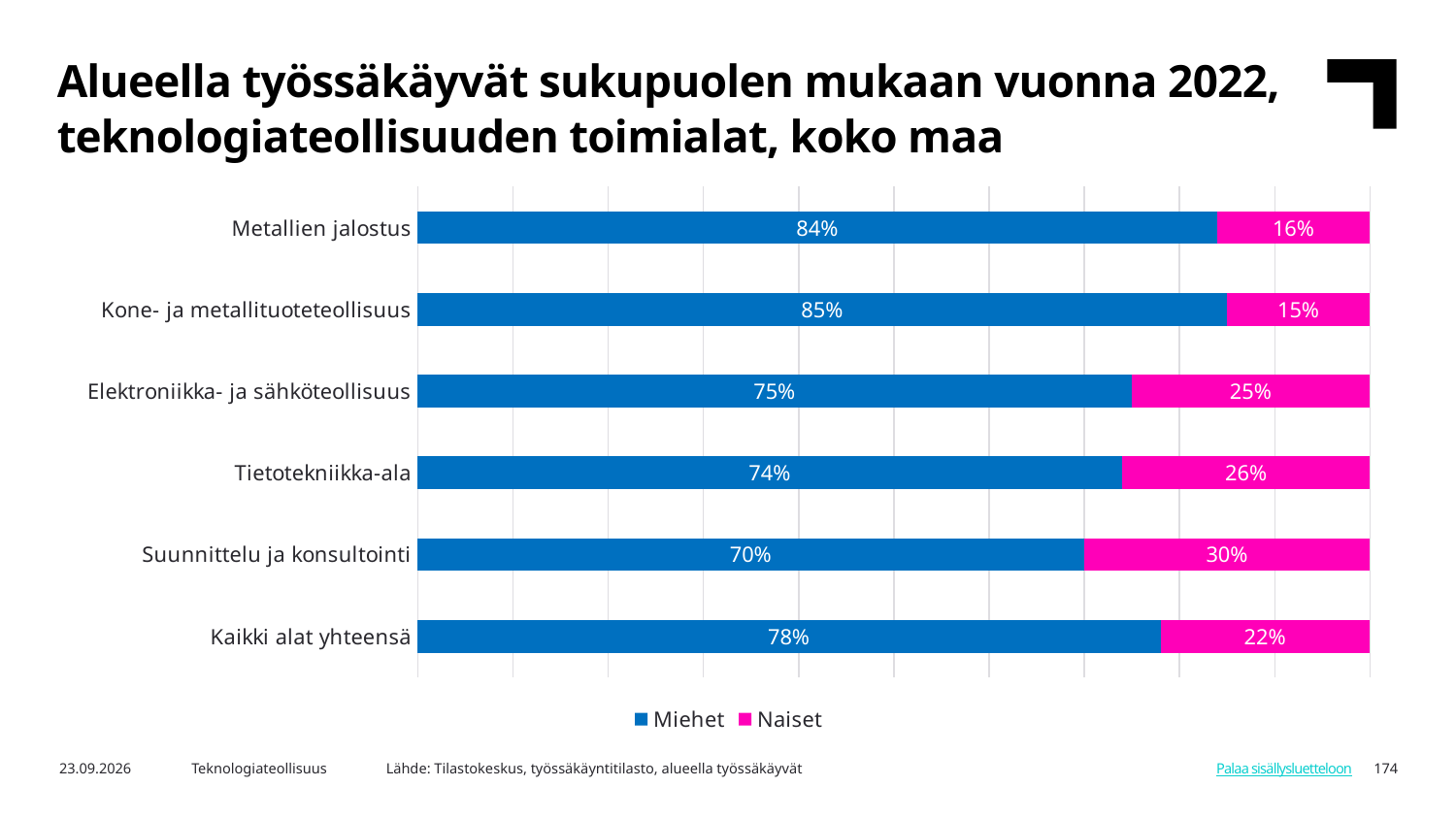
What kind of chart is shown on the slide? Stacked bar chart Which category has the highest Miehet share? Kone- ja metallituoteteollisuus What is the Miehet share for Kaikki alat yhteensä? 78% Which is larger: the Naiset share for Elektroniikka- ja sähköteollisuus or for Kaikki alat yhteensä? Elektroniikka- ja sähköteollisuus What is the Naiset share for Tietotekniikka-ala? 26% Which category has the lowest Miehet share? Suunnittelu ja konsultointi Which category has the highest Naiset share? Suunnittelu ja konsultointi How many series does the legend list? 2 How many categories are shown on the chart? 6 What is the Miehet share for Metallien jalostus? 84% What is the Naiset share for Suunnittelu ja konsultointi? 30% What is the difference between the Naiset share for Suunnittelu ja konsultointi and for Metallien jalostus? 14 percentage points